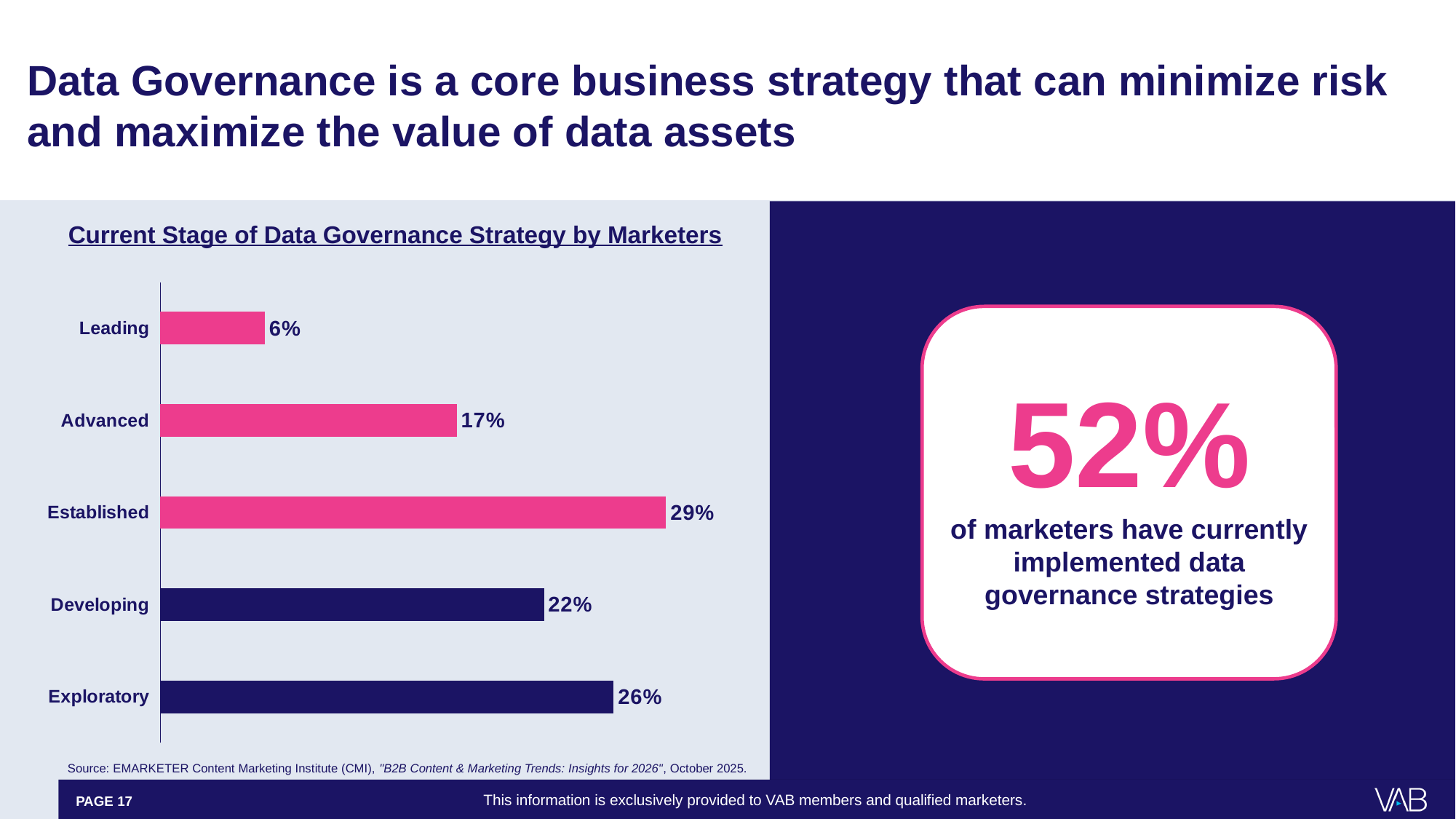
What is the difference between the Established and Advanced percentages? 12% What is the title of the chart on the slide? Current Stage of Data Governance Strategy by Marketers What percentage of marketers are at the Established stage of data governance strategy? 29% What is the combined percentage of the Leading and Advanced stages? 23% What is the value for the Developing stage? 22% Which is larger, the value for Exploratory or the value for Developing? Exploratory What kind of chart is used to show the current stage of data governance strategy? Bar chart Which stage has the lowest percentage of marketers? Leading What is the value shown for the Leading stage? 6% Which stage has the highest percentage of marketers? Established How many stages are shown in the chart? 5 What percentage of marketers are at the Exploratory stage? 26%